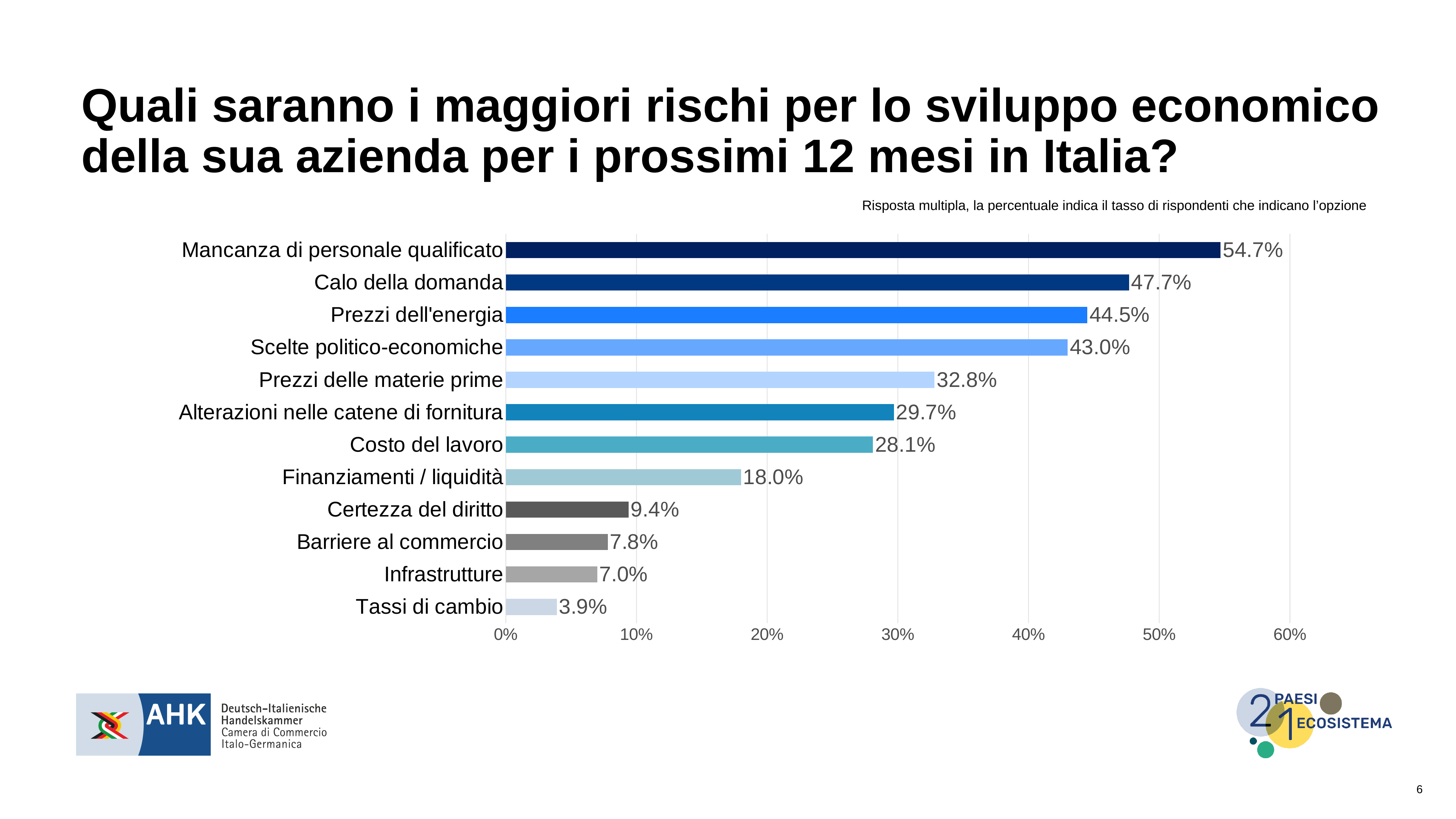
Which is larger, Prezzi delle materie prime or Alterazioni nelle catene di fornitura? Prezzi delle materie prime What is the value for Tassi di cambio? 3.9% What is the difference between Calo della domanda and Prezzi dell'energia? 3.2% Is the value for Finanziamenti / liquidità greater or less than 20%? less Which category has the highest value? Mancanza di personale qualificato How many categories are shown in the chart? 12 What is the highest value shown on the x axis? 60% What is the value for Mancanza di personale qualificato? 54.7% Which category has the lowest value? Tassi di cambio What is the value for Costo del lavoro? 28.1% What is the difference between Certezza del diritto and Infrastrutture? 2.4% What kind of chart is shown on the slide? bar chart